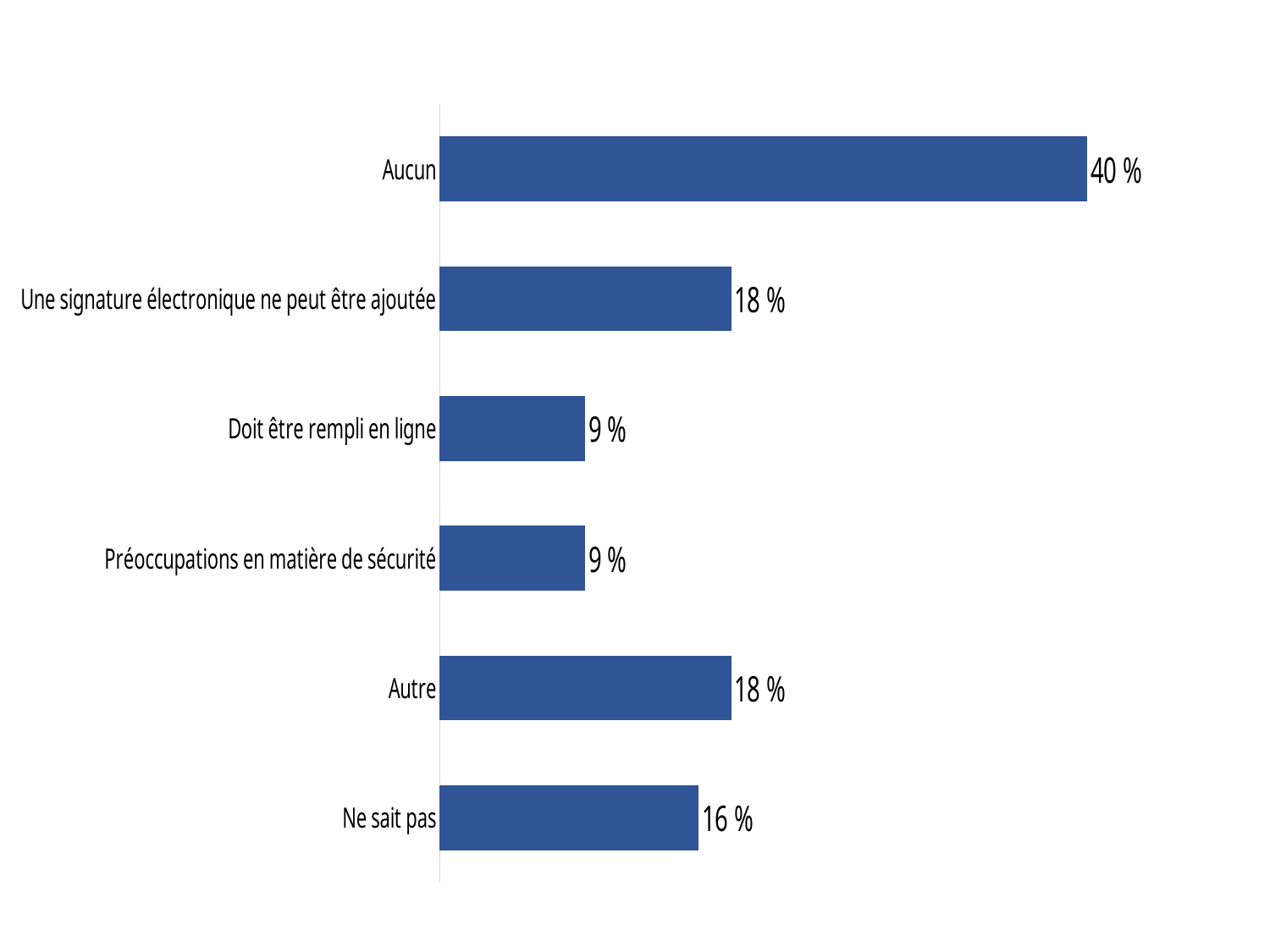
What is the value for "Aucun"? 40 % Which two categories share the same value of 9 %? Doit être rempli en ligne and Préoccupations en matière de sécurité What is the difference between the values for "Aucun" and "Autre"? 22 % What is the difference between the values for "Autre" and "Ne sait pas"? 2 % Which category has the highest value? Aucun Which is larger, the value for "Ne sait pas" or the value for "Préoccupations en matière de sécurité"? Ne sait pas What is the value for "Ne sait pas"? 16 % What is the value for "Doit être rempli en ligne"? 9 % How many categories are shown in the chart? 6 What kind of chart is shown on the slide? Bar chart What colour are the bars in the chart? Blue What is the value for "Une signature électronique ne peut être ajoutée"? 18 %